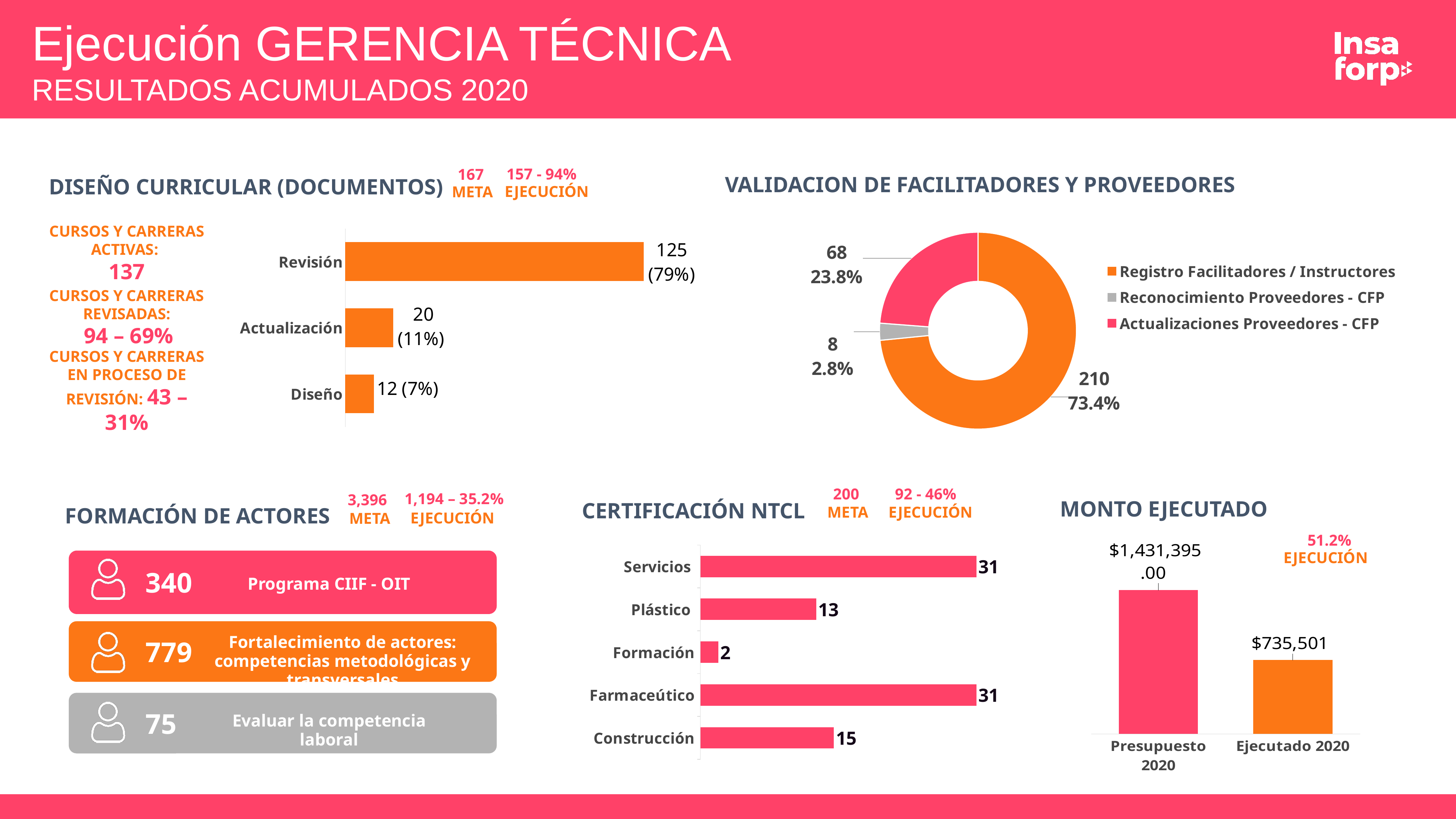
In the Certificación NTCL chart, what is the value for Construcción? 15 In the Monto Ejecutado chart, what is the value for Ejecutado 2020? $735,501 In the Diseño Curricular (Documentos) chart, which category has the lowest value? Diseño In the Diseño Curricular (Documentos) chart, what is the difference between Revisión and Actualización? 105 In the Diseño Curricular (Documentos) chart, what is the value for Revisión? 125 (79%) In the Certificación NTCL chart, how many categories are shown? 5 How many entries does the legend of the Validacion de Facilitadores y Proveedores chart list? 3 In the Monto Ejecutado chart, which is larger, Presupuesto 2020 or Ejecutado 2020? Presupuesto 2020 In the Certificación NTCL chart, which category has the lowest value? Formación In the Diseño Curricular (Documentos) chart, what is the value for Actualización? 20 (11%) In the Validacion de Facilitadores y Proveedores chart, what is the value for Reconocimiento Proveedores - CFP? 8 In the Validacion de Facilitadores y Proveedores chart, what share does Registro Facilitadores / Instructores have? 73.4%